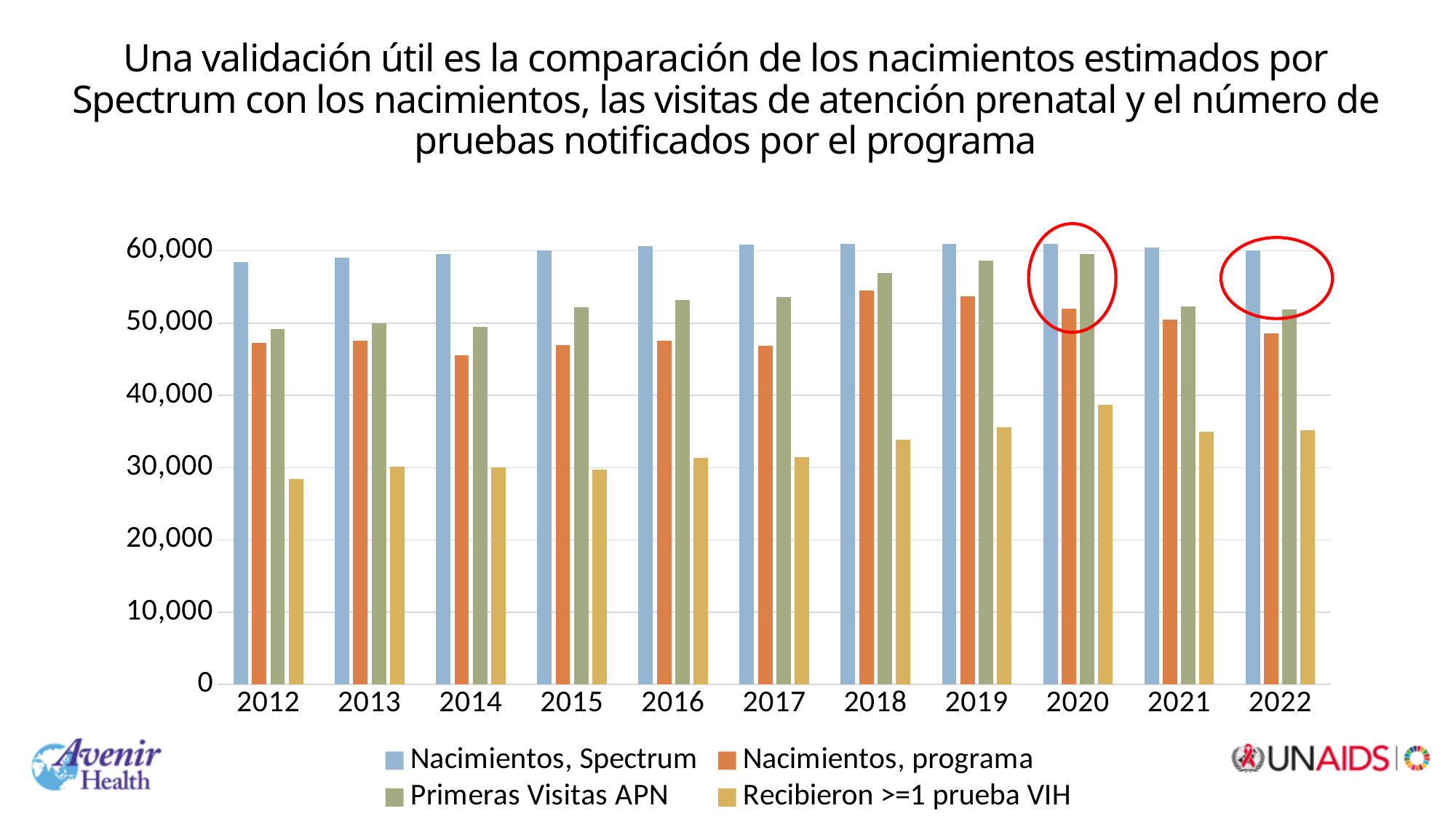
How many series does the chart's legend list? 4 In 2014, which is larger: Nacimientos, programa or Primeras Visitas APN? Primeras Visitas APN Is the value for Nacimientos, Spectrum in 2012 greater or less than 50,000? greater In which year is the value for Recibieron >=1 prueba VIH the lowest? 2012 Which series is shown in blue in the chart? Nacimientos, Spectrum Is the value for Nacimientos, programa in 2018 greater or less than 50,000? greater In which year is the value for Recibieron >=1 prueba VIH the highest? 2020 How many years are shown on the x axis of the chart? 11 In 2020, which is larger: Nacimientos, Spectrum or Nacimientos, programa? Nacimientos, Spectrum Is the value for Recibieron >=1 prueba VIH in 2012 greater or less than 30,000? less What kind of chart is shown on the slide? Bar chart